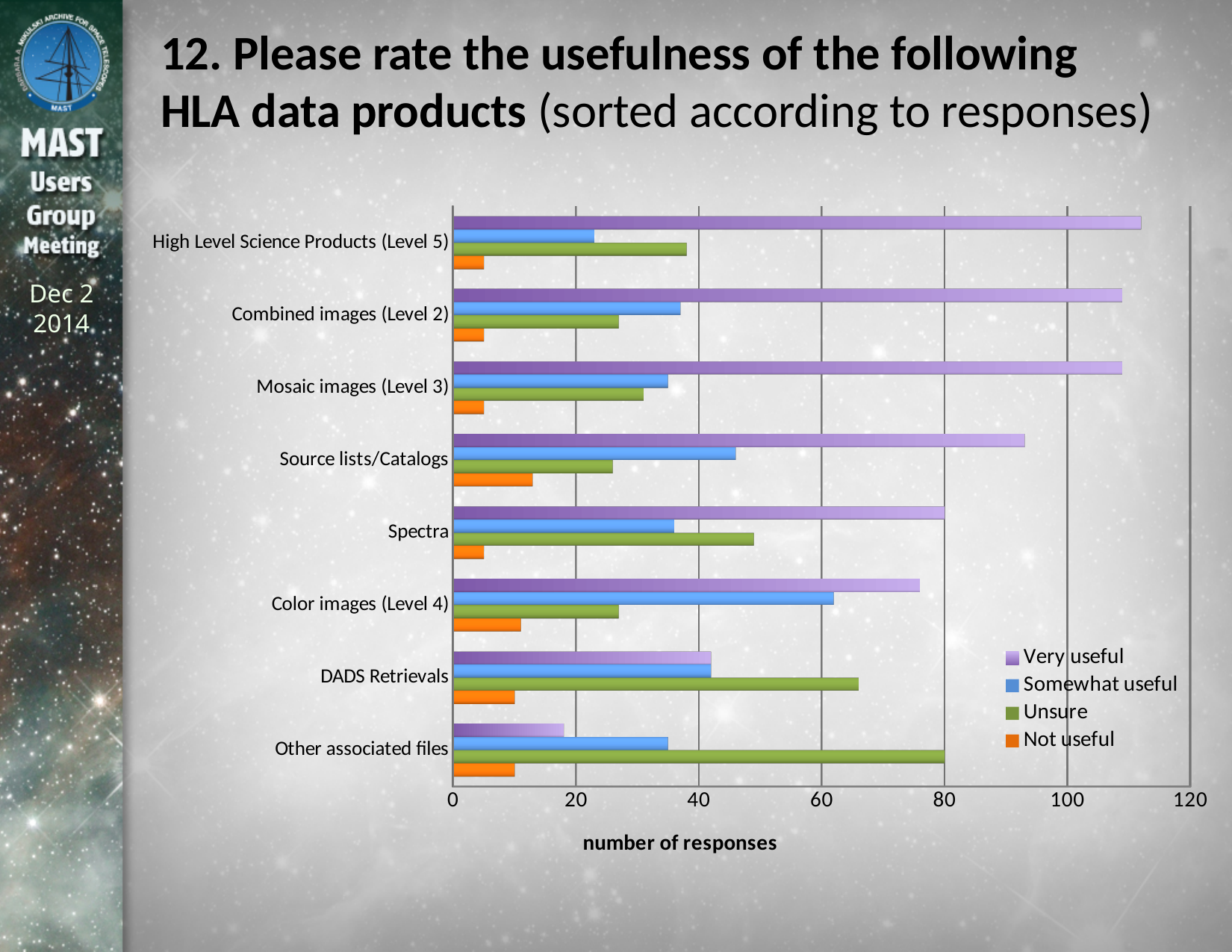
How many series does the legend list? 4 For DADS Retrievals, which is larger: 'Unsure' or 'Very useful'? Unsure What kind of chart is shown on the slide? bar chart Which category has the lowest 'Very useful' value? Other associated files Is the 'Very useful' value for Spectra greater or less than 100? less Is the 'Unsure' value for Other associated files greater or less than 60? greater Is the 'Not useful' value for Source lists/Catalogs greater or less than 20? less For Color images (Level 4), which is larger: 'Somewhat useful' or 'Unsure'? Somewhat useful What is the title of the horizontal axis? number of responses How many HLA data product categories are plotted on the chart? 8 Which category has the highest 'Unsure' value? Other associated files